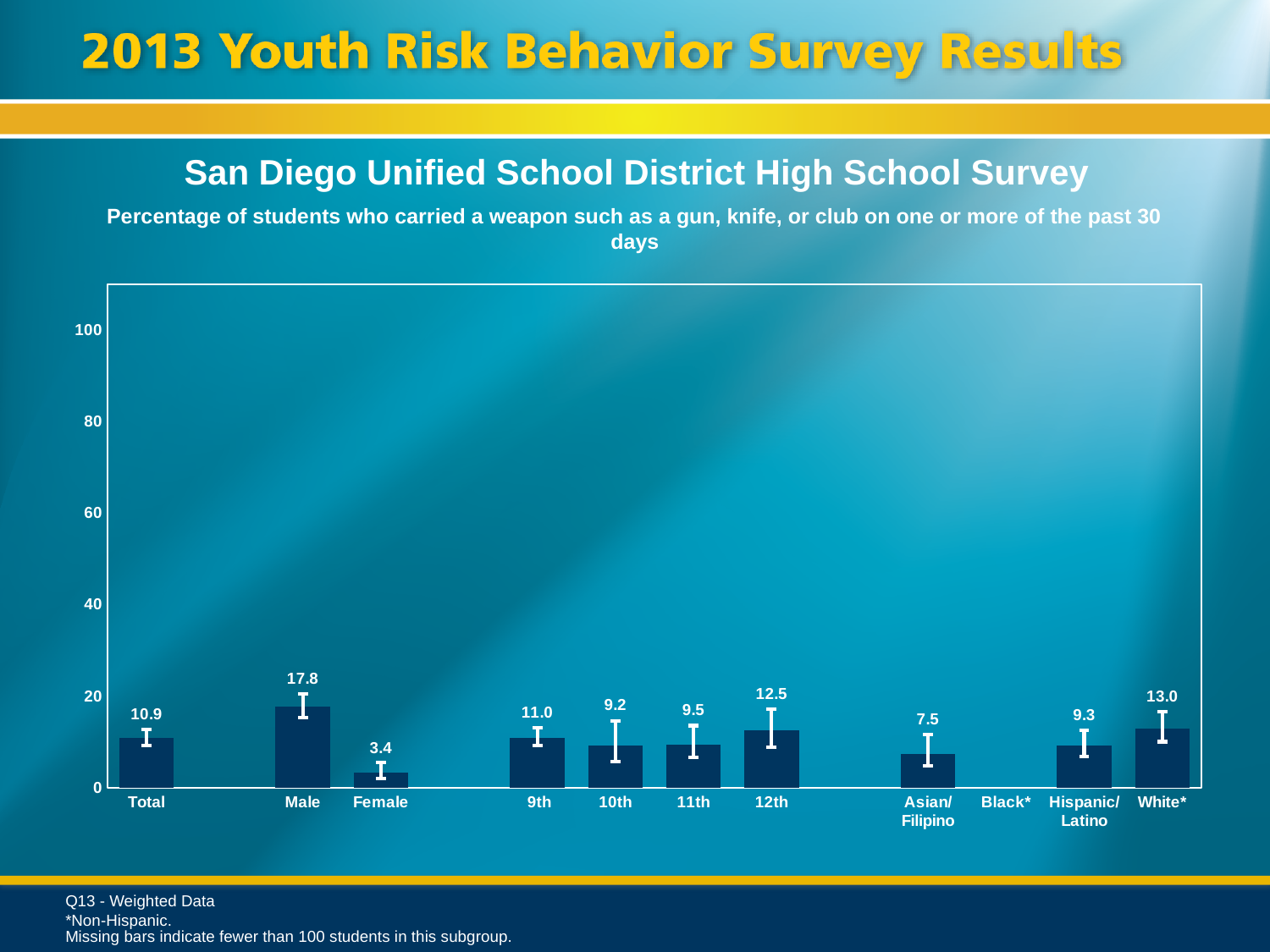
Which category has the lowest plotted value? Female Which category has the highest value? Male What is the difference between the Male and Female values? 14.4 What is the value for Asian/Filipino? 7.5 What is the value for 12th grade? 12.5 Which is larger, the value for White* or the value for Hispanic/Latino? White* What is the value for Female? 3.4 How many categories have a plotted bar? 10 What is the difference between the 12th grade and 10th grade values? 3.3 Is the value for Male greater or less than 20? less What kind of chart is shown? bar chart What is the value for Male? 17.8